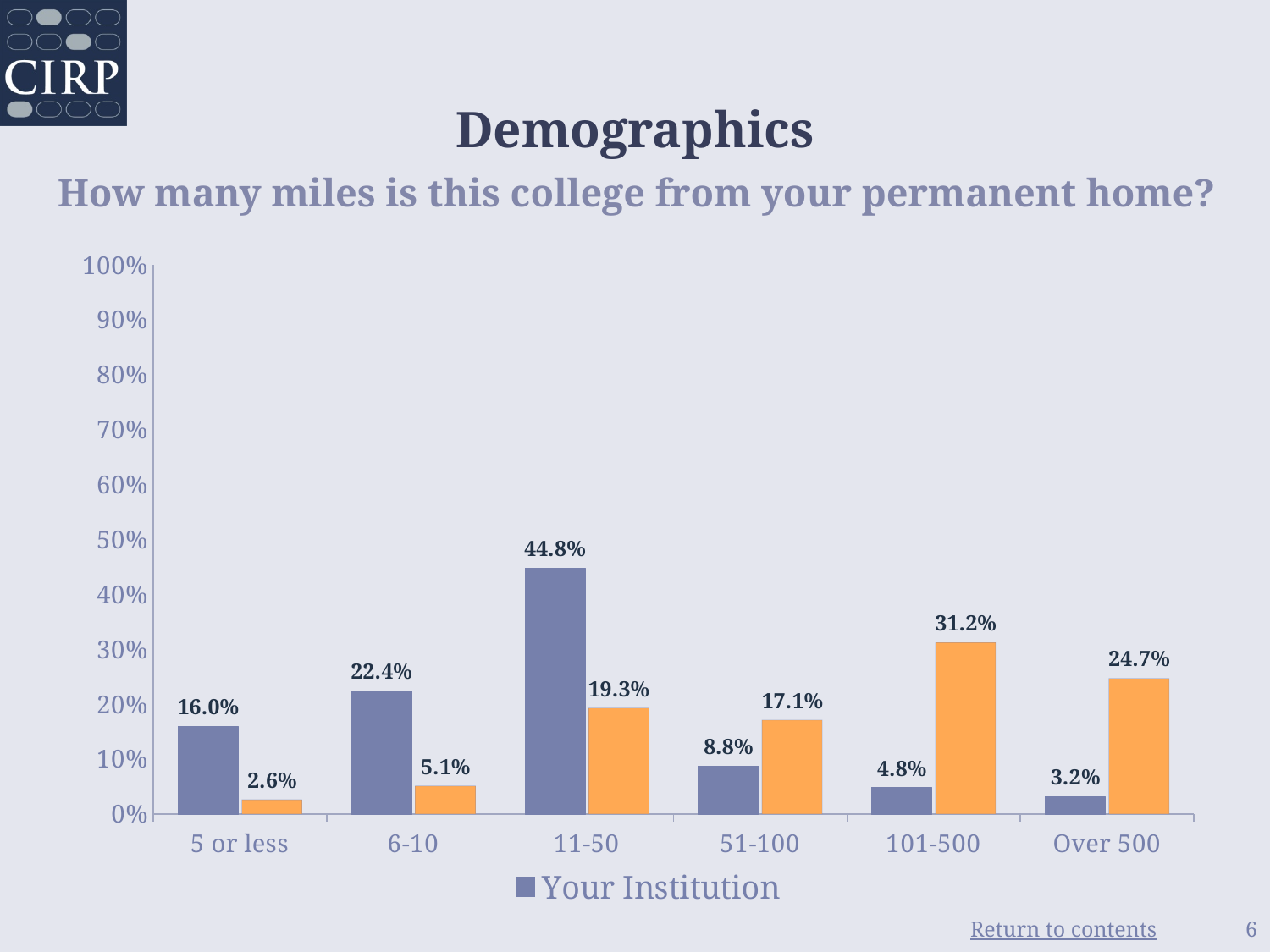
In the 51-100 category, which is larger: the Your Institution bar or the orange bar? the orange bar Which category has the lowest value for Your Institution? Over 500 What is the difference between the Your Institution values for 11-50 and 6-10? 22.4% What kind of chart is shown on the slide? bar chart What series name does the legend list? Your Institution What is the value for Your Institution in the Over 500 category? 3.2% Which category has the highest value for Your Institution? 11-50 What is the value of the orange bar in the 101-500 category? 31.2% How many categories are shown on the x axis? 6 Is the value for Your Institution in the 6-10 category greater or less than 20%? greater What is the value for Your Institution in the 11-50 category? 44.8% What is the value for Your Institution in the 5 or less category? 16.0%